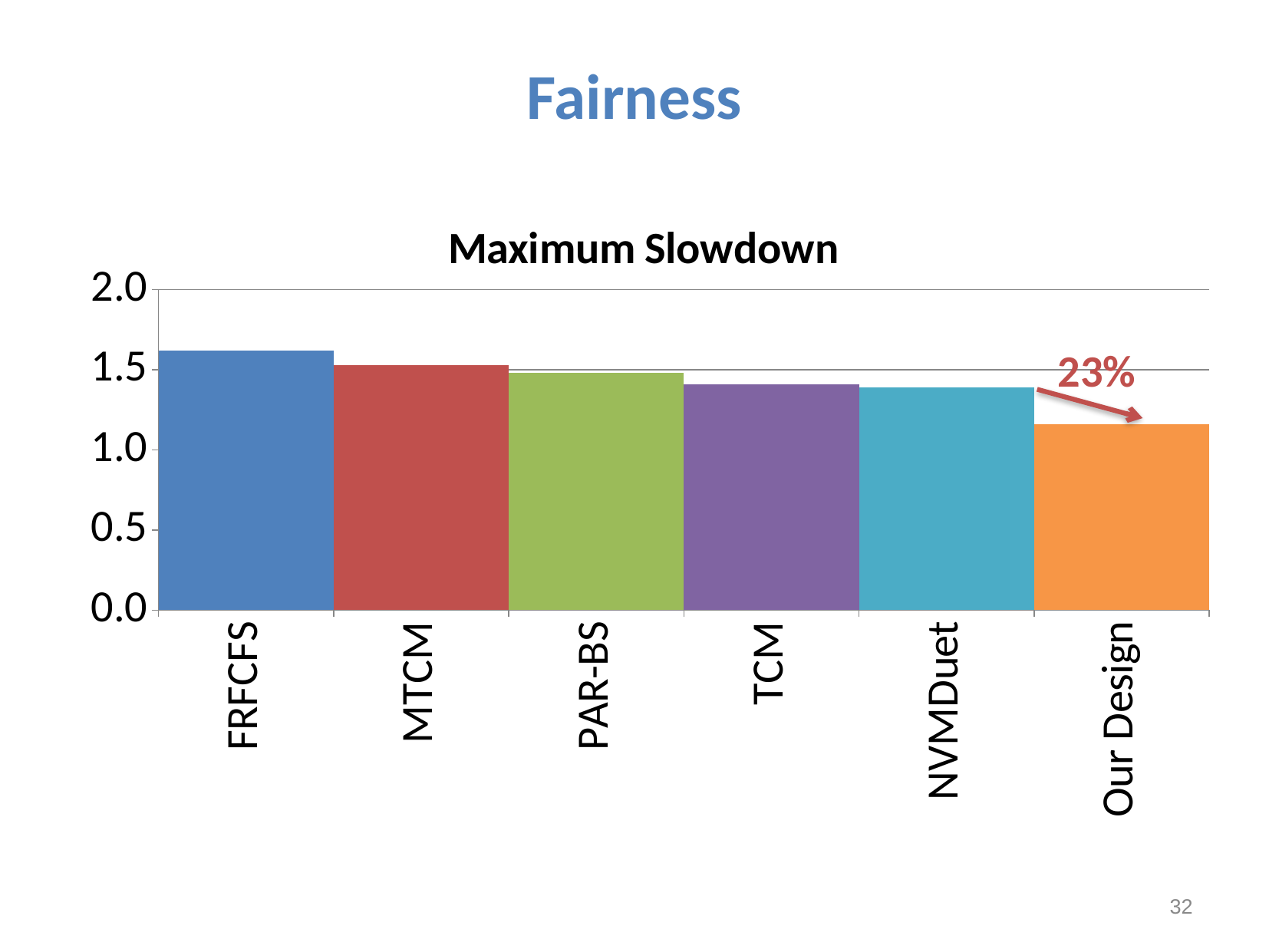
What is the title of the chart? Maximum Slowdown Which category has the lowest maximum slowdown? Our Design How many categories (bars) are shown in the chart? 6 Is the value for Our Design greater or less than 1.5? less Is the value for FRFCFS greater or less than 1.5? greater Which category has the highest maximum slowdown? FRFCFS Is the value for Our Design greater or less than 1.0? greater Do the bar values rise or fall from left to right across the x axis? fall What percentage is annotated next to the arrow pointing to the Our Design bar? 23% Which has a larger maximum slowdown, MTCM or TCM? MTCM What kind of chart is shown on the slide? bar chart